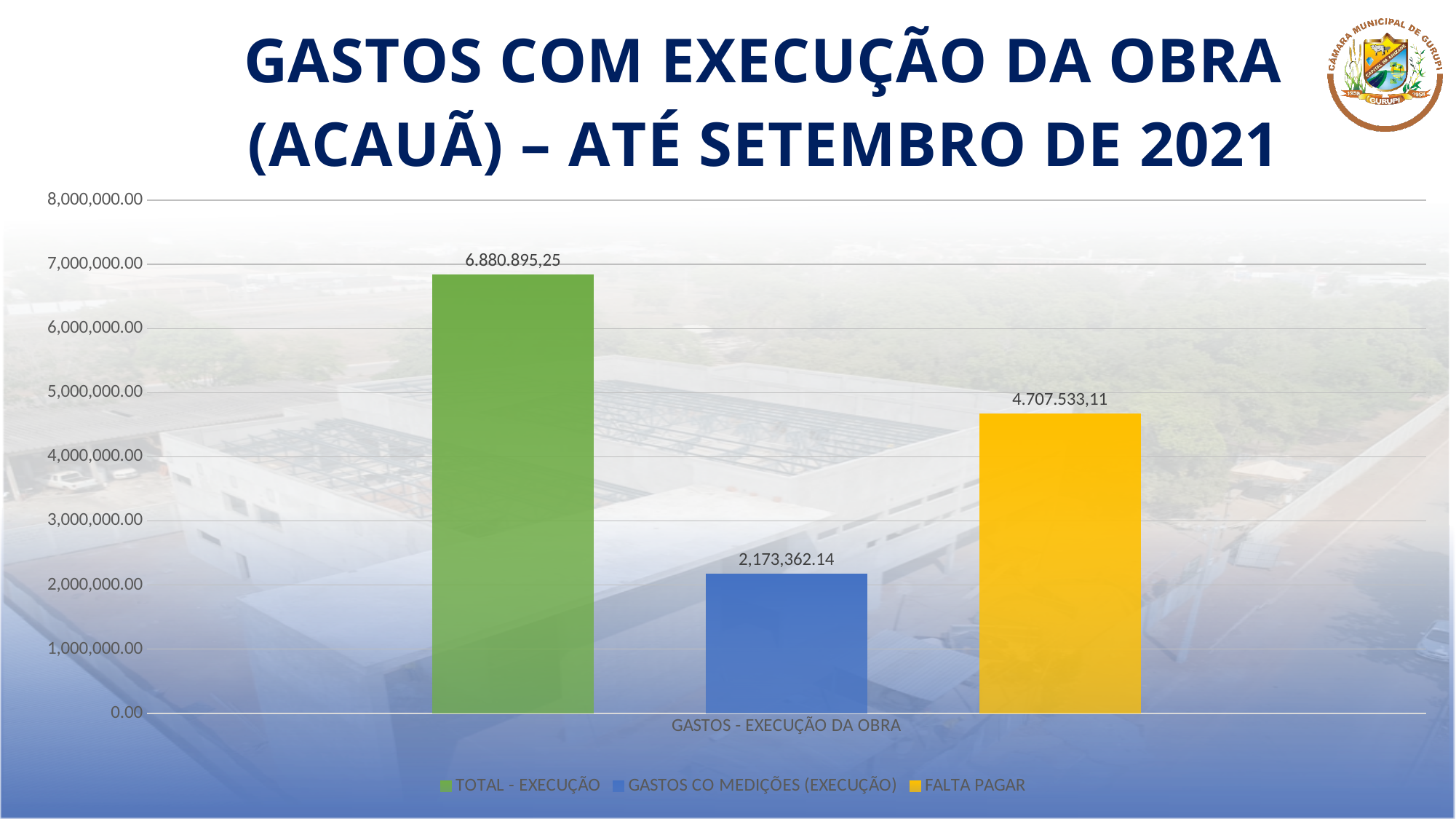
What is the category label shown on the x axis? GASTOS - EXECUÇÃO DA OBRA What kind of chart is shown on the slide? bar chart Is the value for FALTA PAGAR greater or less than 4,000,000.00? greater How many series does the legend list? 3 Which series has the lowest value? GASTOS CO MEDIÇÕES (EXECUÇÃO) What colour is the FALTA PAGAR bar? yellow What is the value of the FALTA PAGAR bar? 4.707.533,11 Is the value for GASTOS CO MEDIÇÕES (EXECUÇÃO) greater or less than 3,000,000.00? less What is the value of the TOTAL - EXECUÇÃO bar? 6.880.895,25 What is the value of the GASTOS CO MEDIÇÕES (EXECUÇÃO) bar? 2,173,362.14 Which series has the highest value? TOTAL - EXECUÇÃO Which is larger, FALTA PAGAR or GASTOS CO MEDIÇÕES (EXECUÇÃO)? FALTA PAGAR